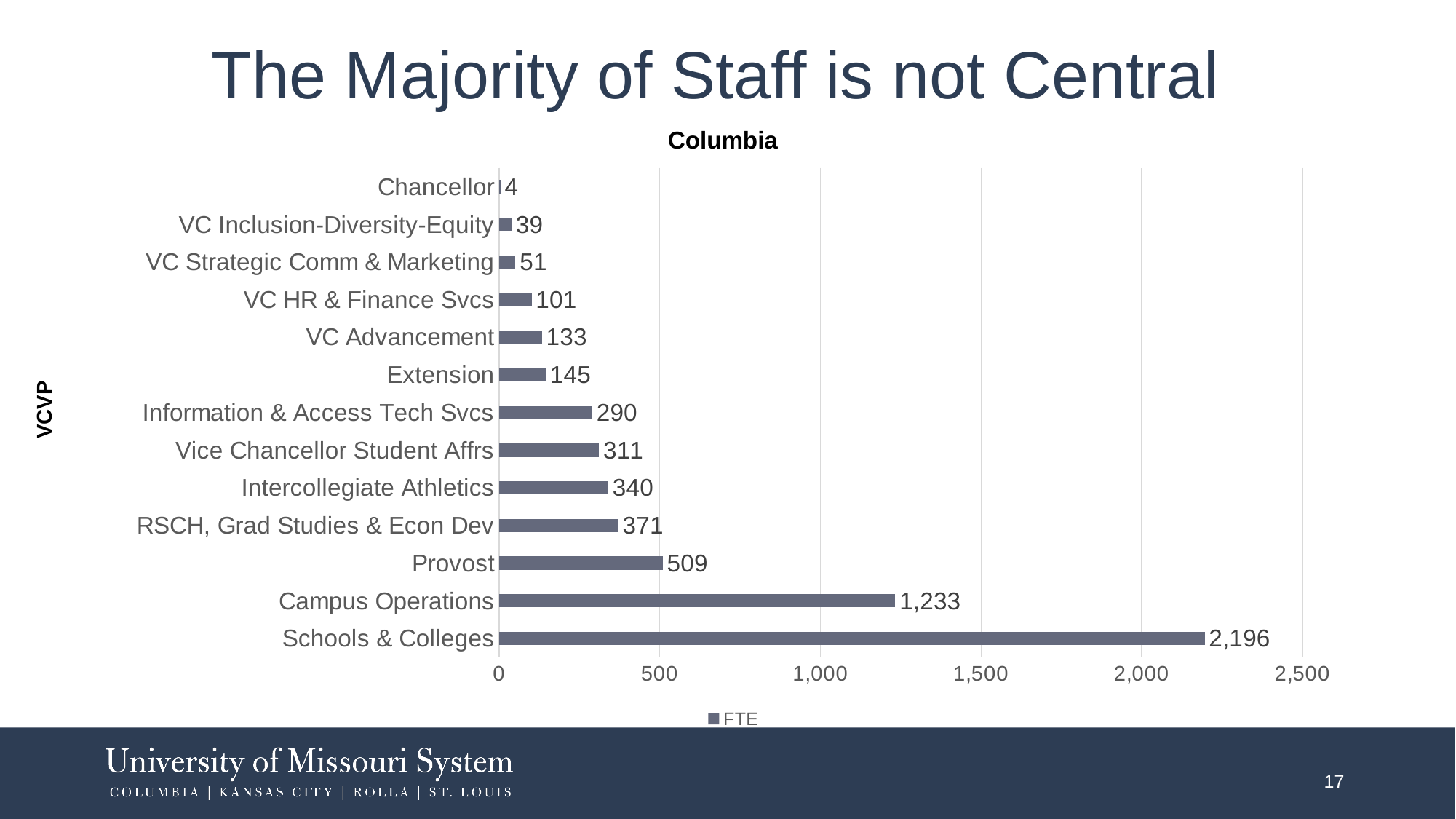
Which category has the lowest FTE? Chancellor What is the difference in FTE between Schools & Colleges and Campus Operations? 963 How many categories are shown on the chart? 13 What is the FTE value for VC HR & Finance Svcs? 101 What is the title of the chart? Columbia What kind of chart is shown on the slide? Bar chart Which category has the highest FTE? Schools & Colleges How many series does the legend list? 1 What is the FTE value for Extension? 145 Which has a larger FTE, Intercollegiate Athletics or Vice Chancellor Student Affrs? Intercollegiate Athletics Is the FTE value for Provost greater or less than 500? greater What is the FTE value for Campus Operations? 1,233